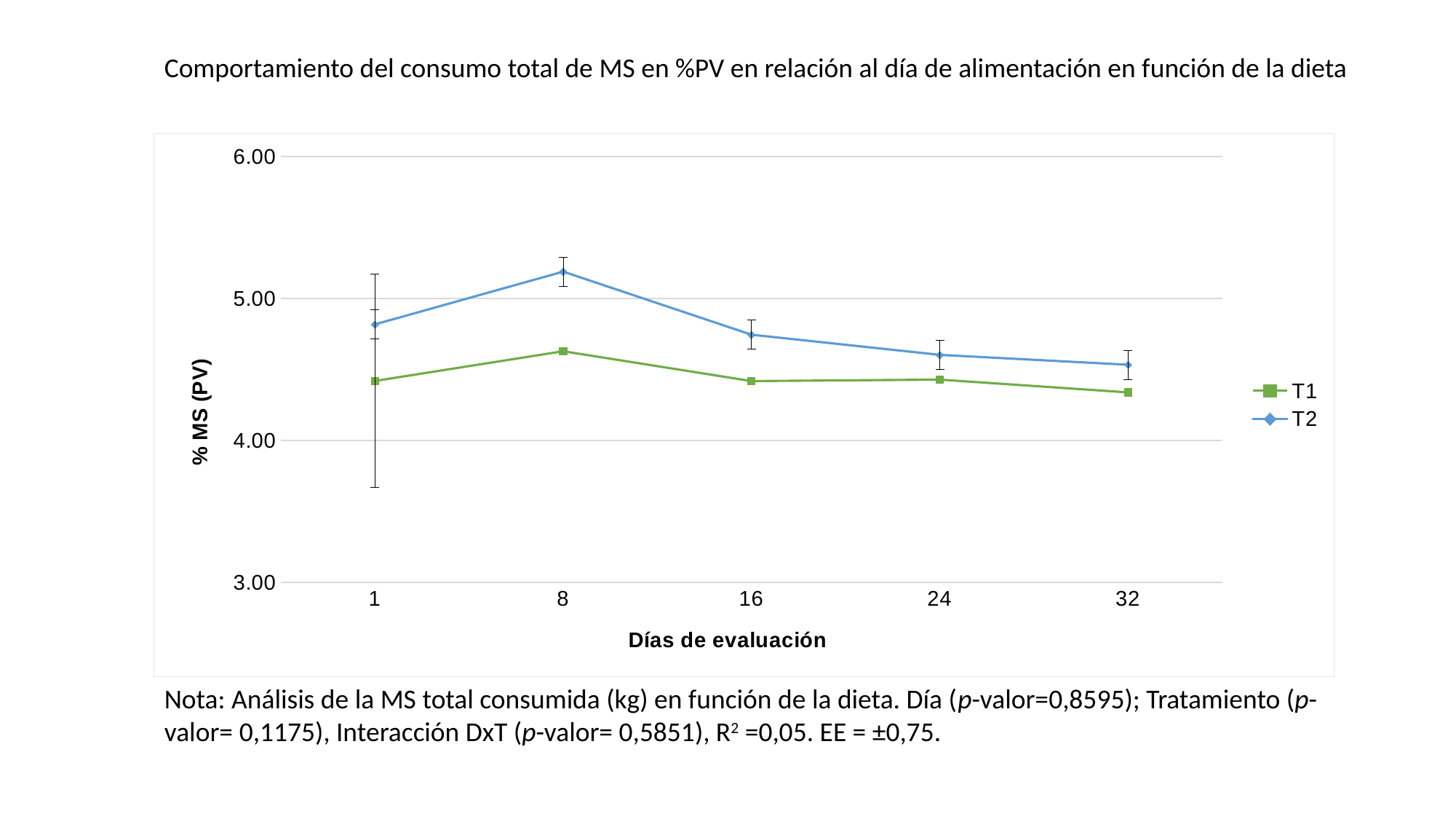
From day 8 to day 32, does the T2 line rise or fall? Fall Is the value for T1 on day 8 greater or less than 5.00? less On which evaluation day does T1 reach its highest value? 8 How many evaluation days are plotted along the x axis? 5 Is the value for T2 on day 16 greater or less than 5.00? less Is the value for T1 on day 32 greater or less than 4.00? greater How many series does the legend list? 2 What kind of chart is shown on the slide? Line chart What is the title of the y axis? % MS (PV) Which series has the larger value on day 8, T1 or T2? T2 On which evaluation day does T2 reach its highest value? 8